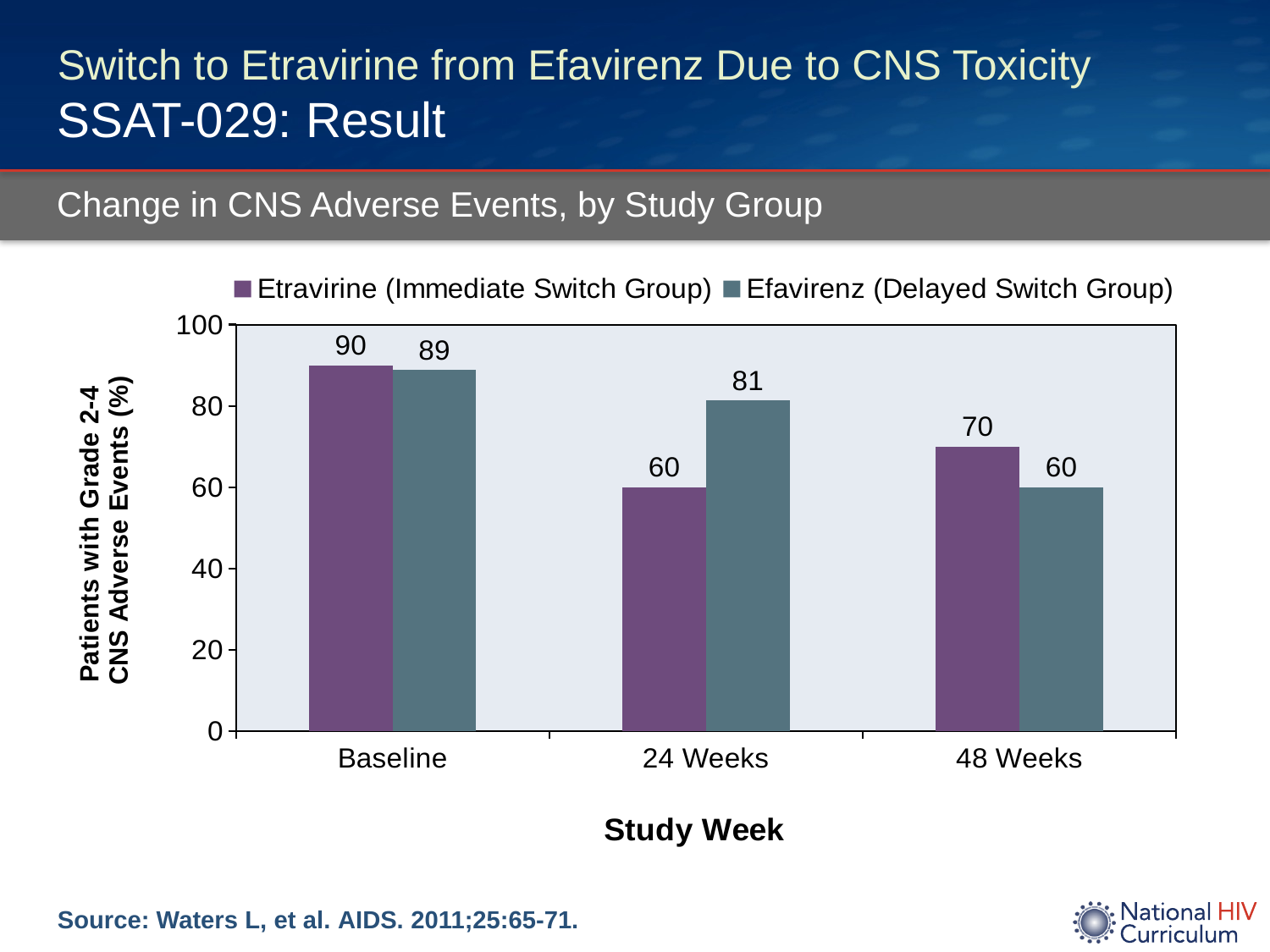
At which study week is the Etravirine (Immediate Switch Group) value lowest? 24 Weeks What is the value for Efavirenz (Delayed Switch Group) at 24 Weeks? 81 What is the difference between the Efavirenz (Delayed Switch Group) and Etravirine (Immediate Switch Group) values at 24 Weeks? 21 Is the value for Efavirenz (Delayed Switch Group) at 24 Weeks greater or less than 80? greater How many series does the legend list? 2 What is the value for Efavirenz (Delayed Switch Group) at 48 Weeks? 60 At which study week is the Efavirenz (Delayed Switch Group) value highest? Baseline How many study week categories are shown on the x axis? 3 What is the value for Etravirine (Immediate Switch Group) at 48 Weeks? 70 What is the value for Etravirine (Immediate Switch Group) at Baseline? 90 What kind of chart is shown on the slide? Bar chart At 48 Weeks, which group has the larger value, Etravirine (Immediate Switch Group) or Efavirenz (Delayed Switch Group)? Etravirine (Immediate Switch Group)